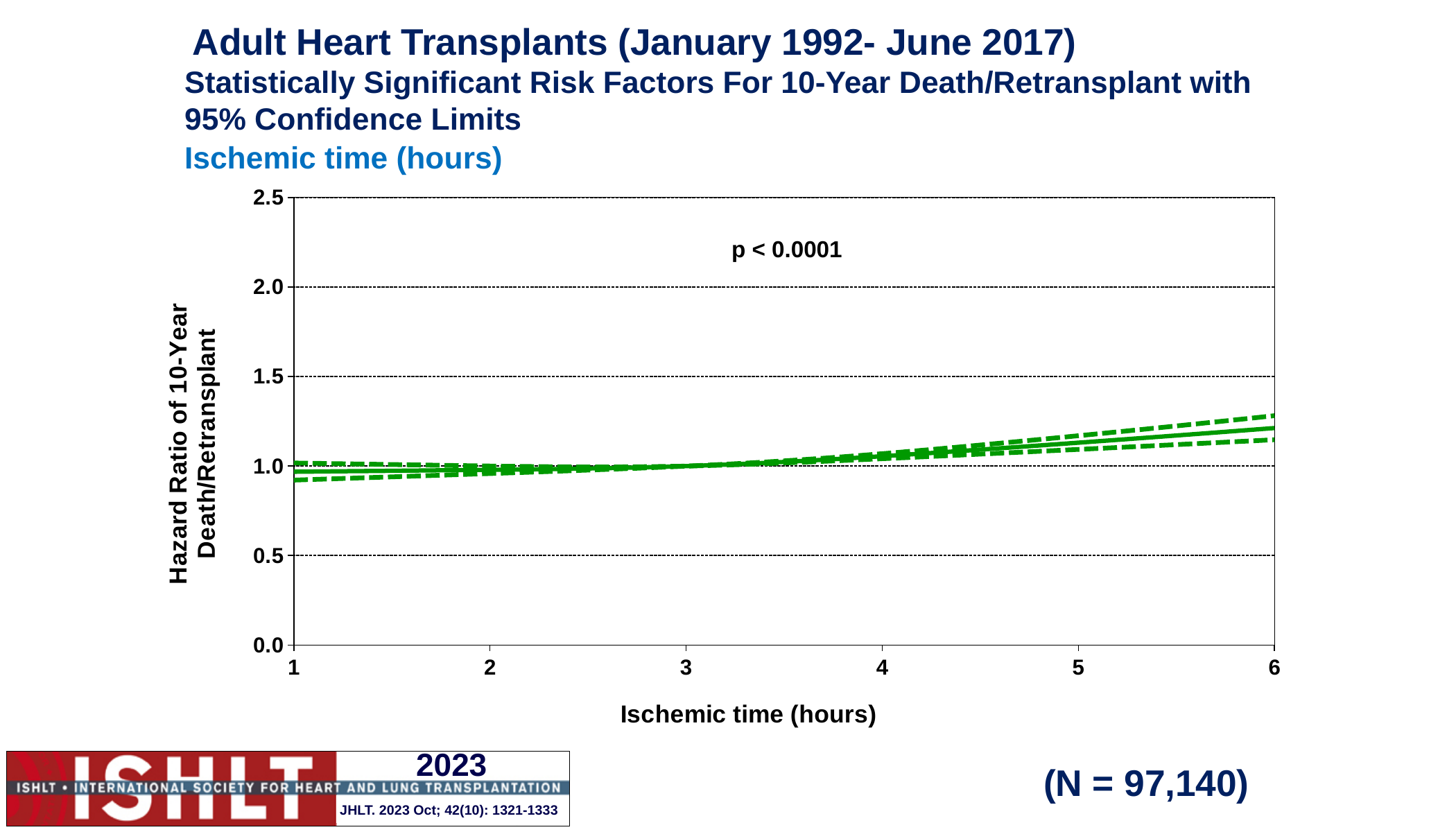
What kind of chart is shown on the slide? line chart Is the hazard ratio at an ischemic time of 5 hours greater or less than 1.5? less Does the hazard ratio rise or fall as ischemic time increases from 1 to 6 hours? rise What is the highest value shown on the y axis? 2.5 Is the hazard ratio at an ischemic time of 6 hours greater or less than 1.5? less What is the label of the x axis? Ischemic time (hours) What is the lowest ischemic time shown on the x axis? 1 Is the hazard ratio at an ischemic time of 6 hours greater or less than 1.0? greater What p-value is printed on the chart? p < 0.0001 What is the sample size (N) stated on the slide? 97,140